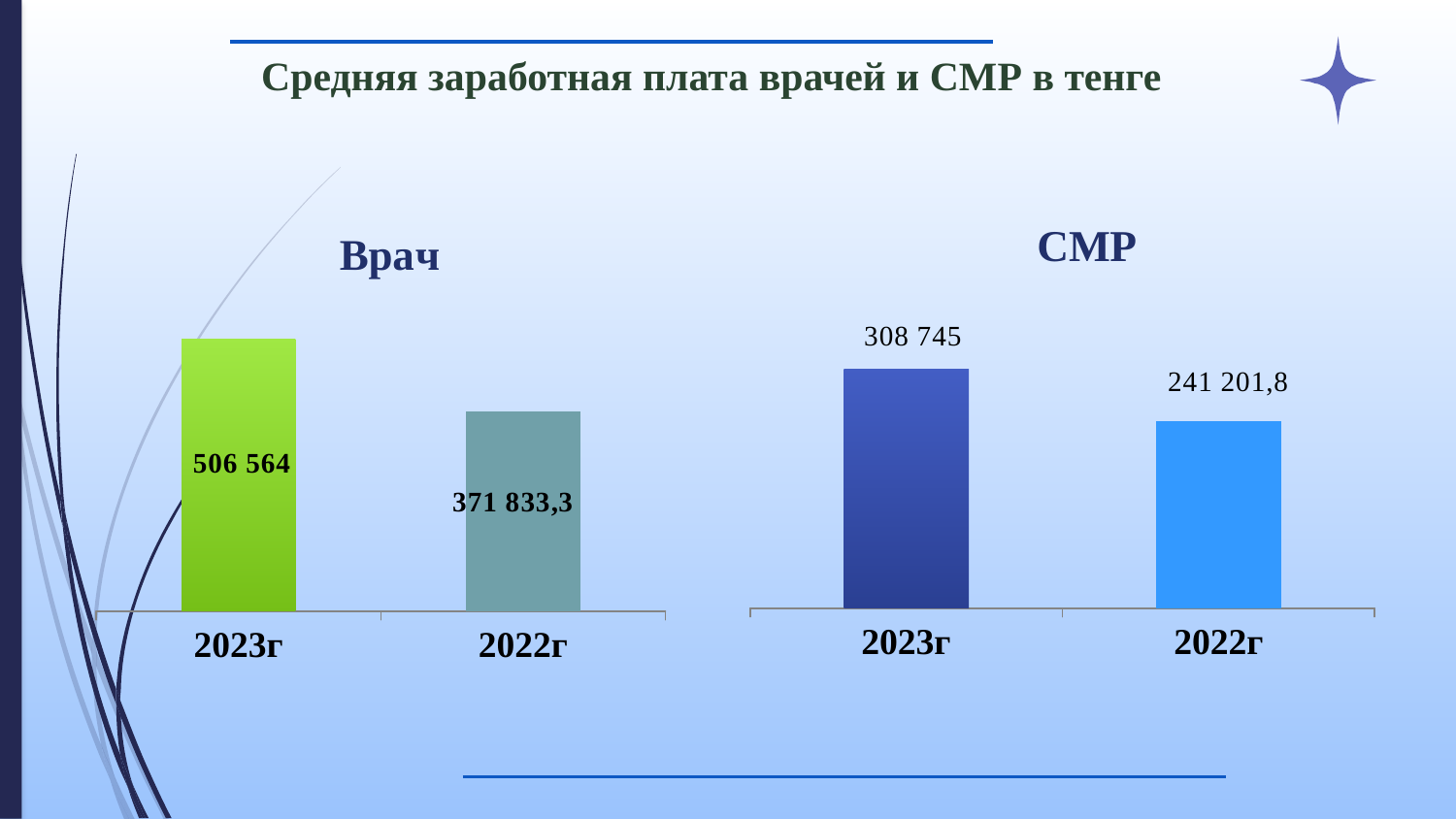
In the "Врач" chart, what is the value for 2022г? 371 833,3 In the "СМР" chart, what is the difference between the 2023г and 2022г values? 67 543,2 How many bars are shown in the "СМР" chart? 2 In the "СМР" chart, what is the value for 2022г? 241 201,8 What type of chart is the "Врач" chart? bar chart In the "Врач" chart, what is the value for 2023г? 506 564 In the "СМР" chart, what is the value for 2023г? 308 745 In the "Врач" chart, which year has the higher value? 2023г Is the 2023г value in the "Врач" chart larger or smaller than the 2023г value in the "СМР" chart? larger In the "Врач" chart, what is the difference between the 2023г and 2022г values? 134 730,7 In the "СМР" chart, which year has the lower value? 2022г What is the title of the slide containing the two charts? Средняя заработная плата врачей и СМР в тенге